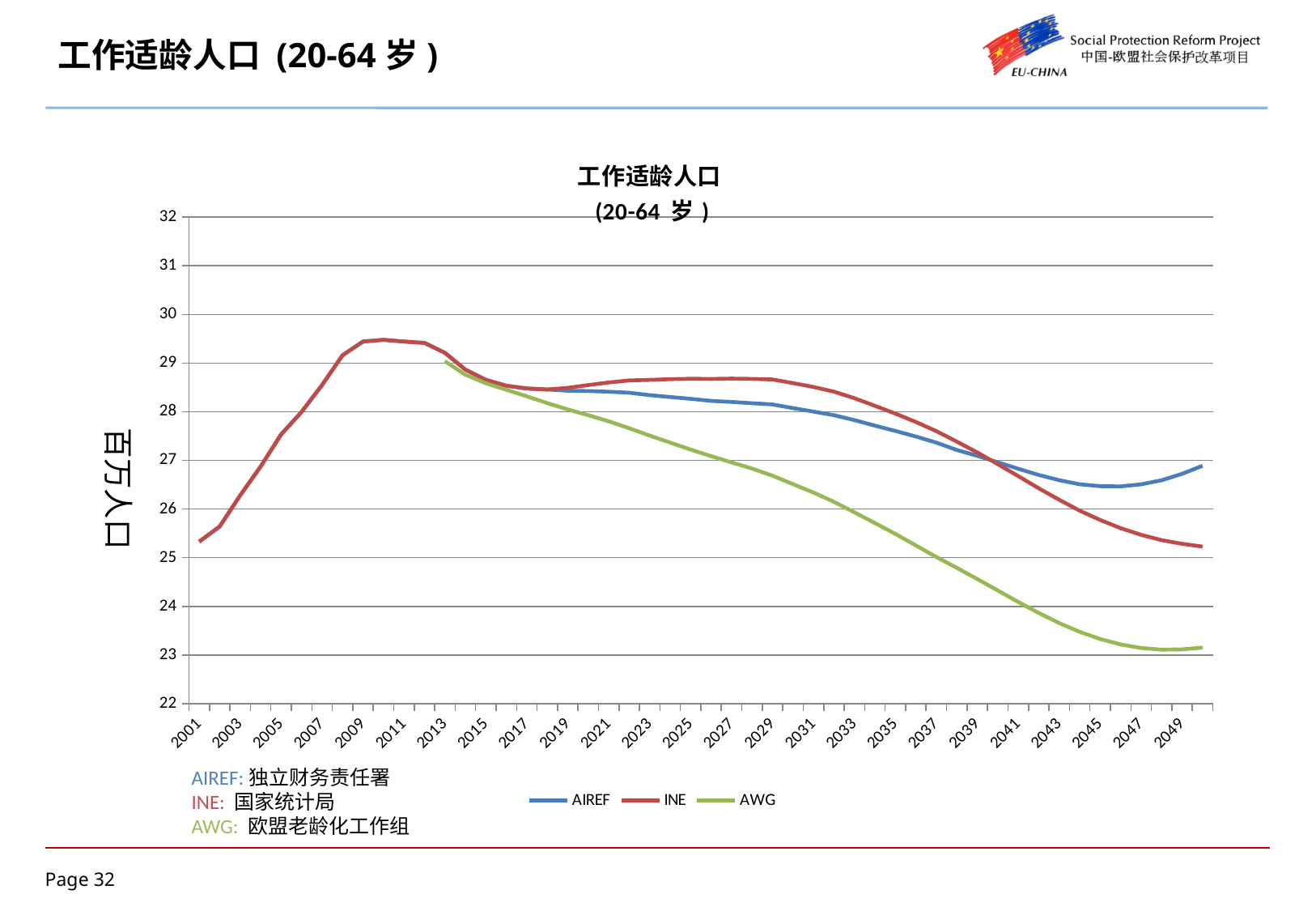
Is the value for INE in 2009 greater or less than 29? greater How many series does the legend list? 3 Does the AWG series rise or fall from 2013 to 2049? fall Is the value for AWG in 2049 greater or less than 24? less What is the label on the vertical axis? 百万人口 What are the three series named in the legend? AIREF, INE, AWG Is the value for AIREF in 2045 greater or less than 27? less What kind of chart is shown on the slide? line chart In 2049, which series has the higher value, AIREF or INE? AIREF Which series has the lowest value in 2049? AWG In 2041, which series has the higher value, INE or AWG? INE